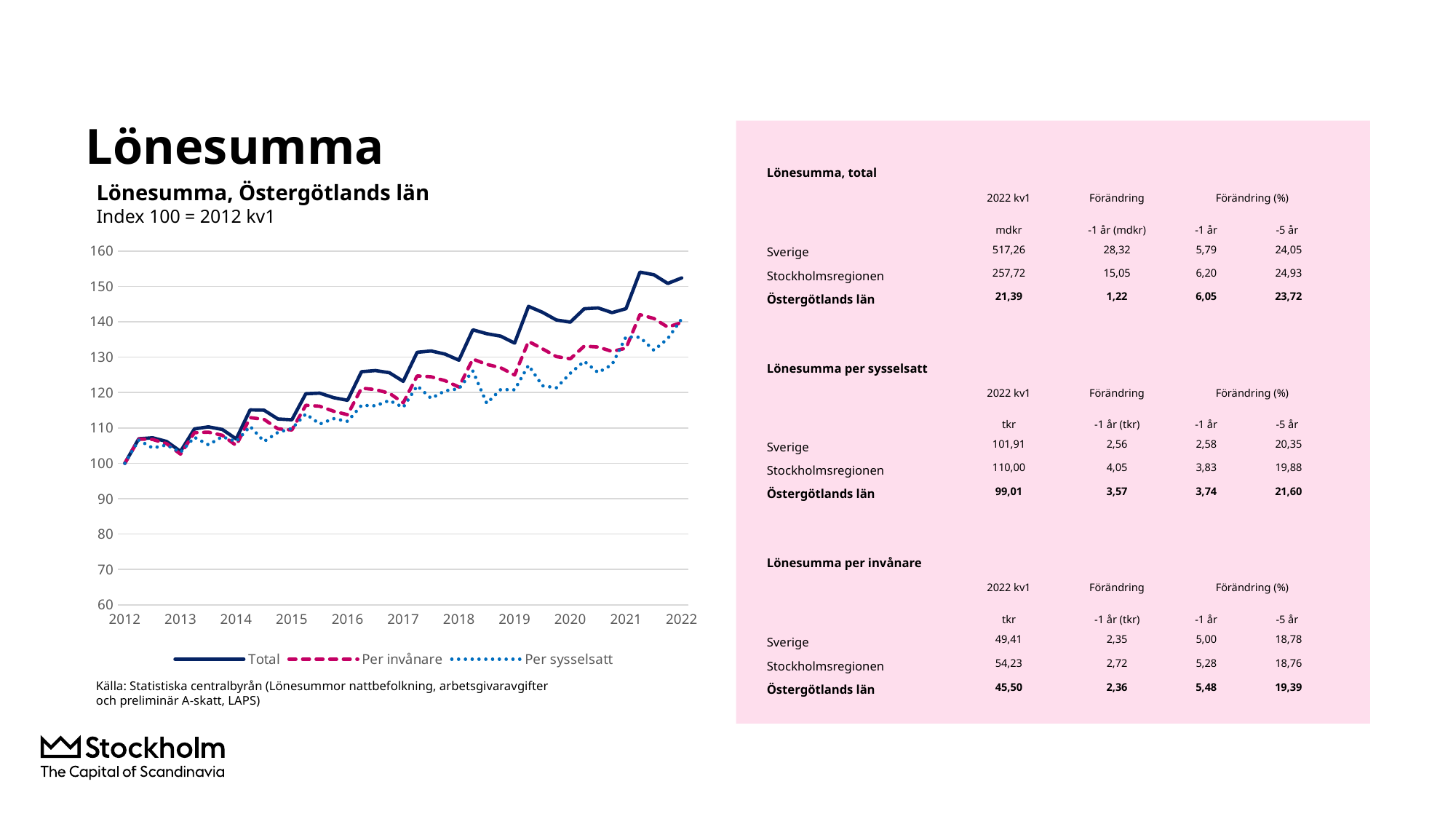
Is the value for Per sysselsatt at 2017 greater or less than 120? less Is the value for Total at 2019 greater or less than 130? greater What kind of chart is shown on the slide? line chart At 2022, which is larger: Total or Per sysselsatt? Total Does the Total series rise or fall from 2012 to 2022? rise How many year labels are shown on the x axis of the chart? 11 Which series has the lowest value at 2019? Per sysselsatt Which series has the highest value at the end of the period in 2022? Total Which series in the chart is drawn with a dotted line? Per sysselsatt What is the title of the chart? Lönesumma, Östergötlands län How many series does the legend of the chart list? 3